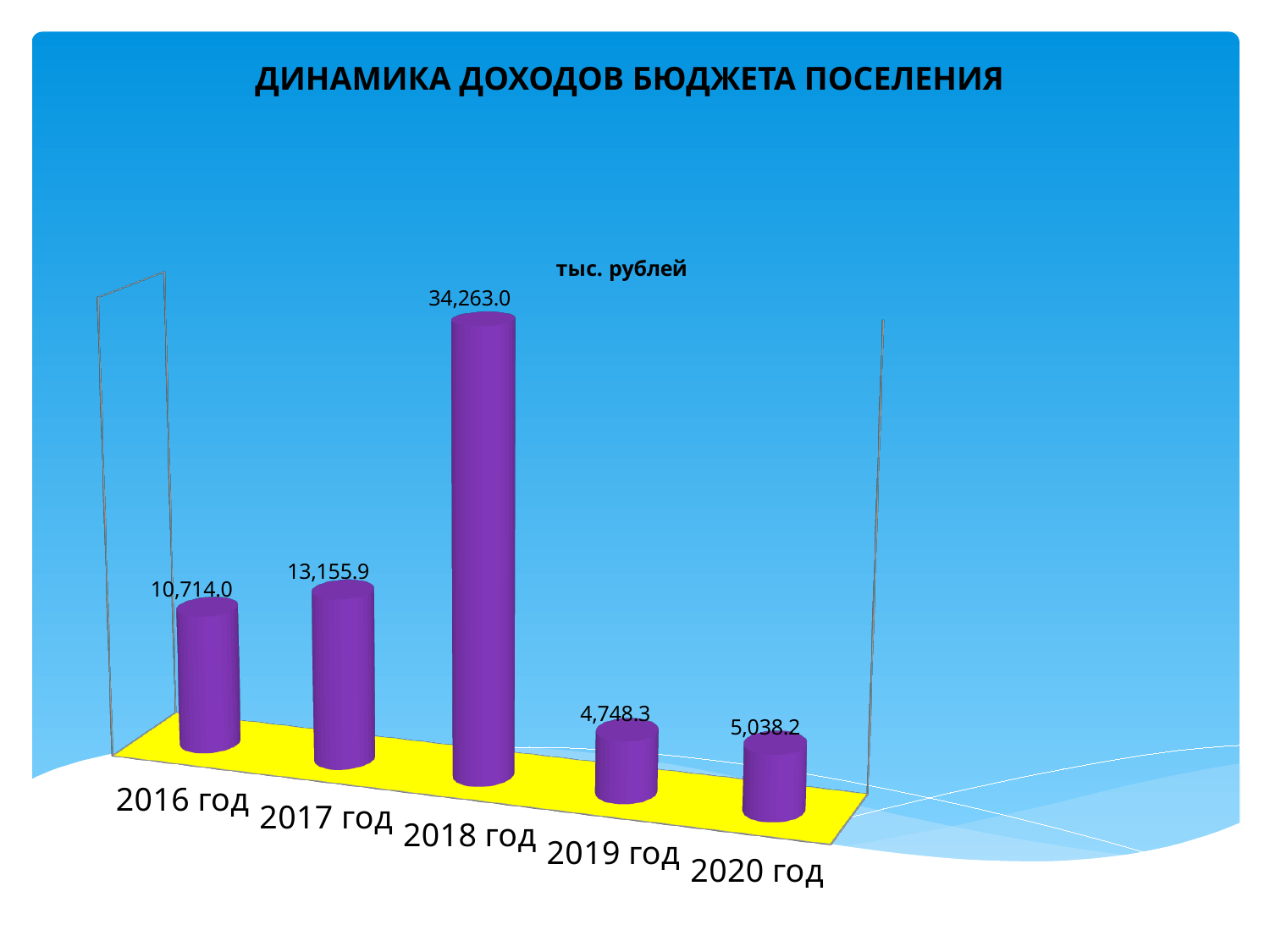
What is the difference between the values for 2017 год and 2016 год? 2,441.9 What is the difference between the values for 2018 год and 2017 год? 21,107.1 What is the value for 2018 год? 34,263.0 How many years are shown on the chart? 5 Which year has the lowest value? 2019 год What unit is indicated for the values on the chart? тыс. рублей Which year has the highest value? 2018 год What is the value for 2016 год? 10,714.0 What is the value for 2020 год? 5,038.2 What kind of chart is shown on the slide? Bar chart Which is larger, the value for 2016 год or the value for 2017 год? 2017 год What is the value for 2019 год? 4,748.3